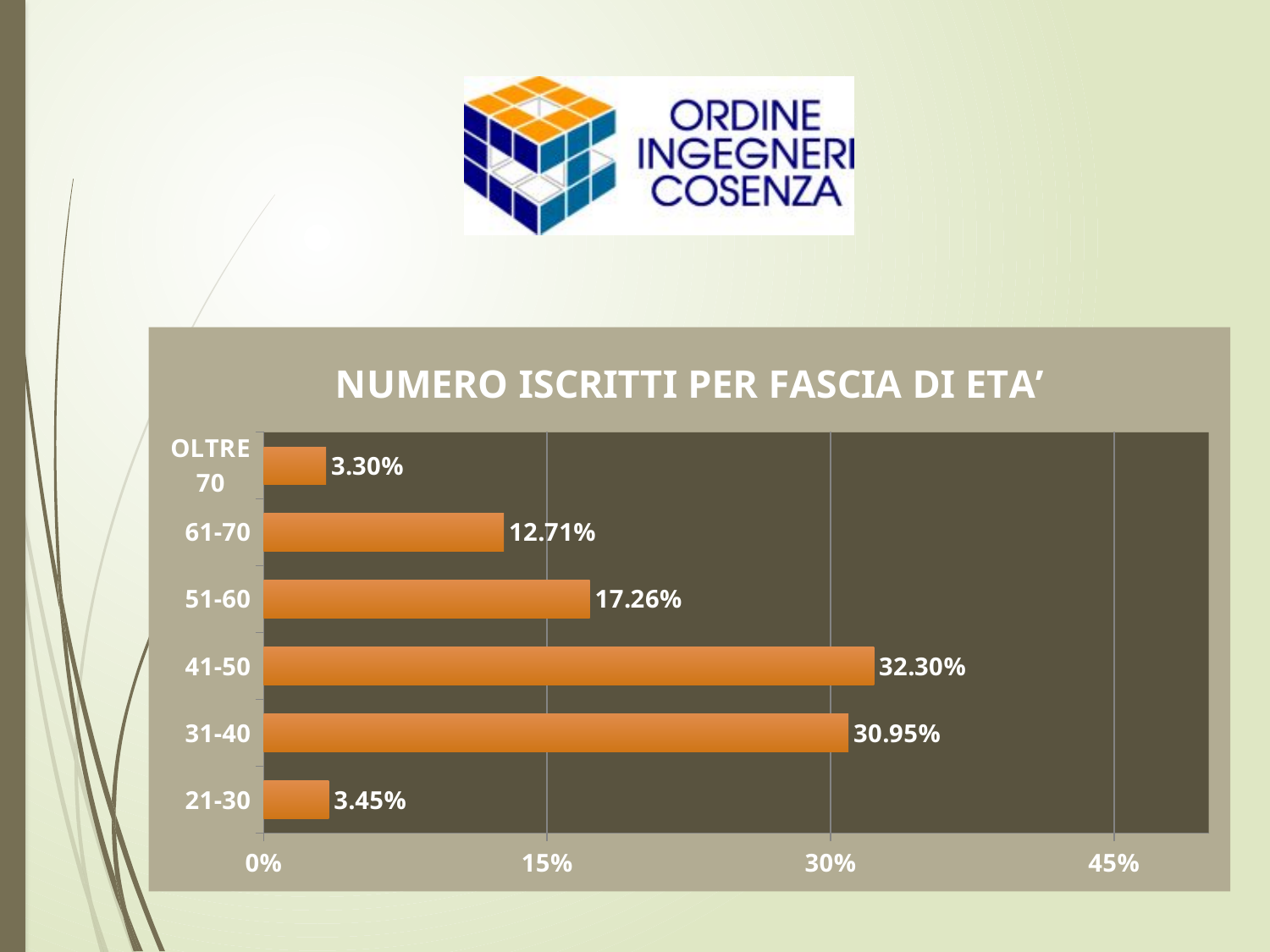
What is the difference between the values for 41-50 and 31-40? 1.35% What is the value for the 41-50 age group? 32.30% What kind of chart is shown on the slide? bar chart What is the difference between the values for 51-60 and 61-70? 4.55% Which is larger, the value for 51-60 or the value for 61-70? 51-60 Is the value for 31-40 greater or less than 30%? greater Which age group has the lowest value? OLTRE 70 What is the value for the 61-70 age group? 12.71% How many age groups are shown in the chart? 6 What is the title of the chart? NUMERO ISCRITTI PER FASCIA DI ETA' What is the value for the OLTRE 70 age group? 3.30% Which age group has the highest value? 41-50